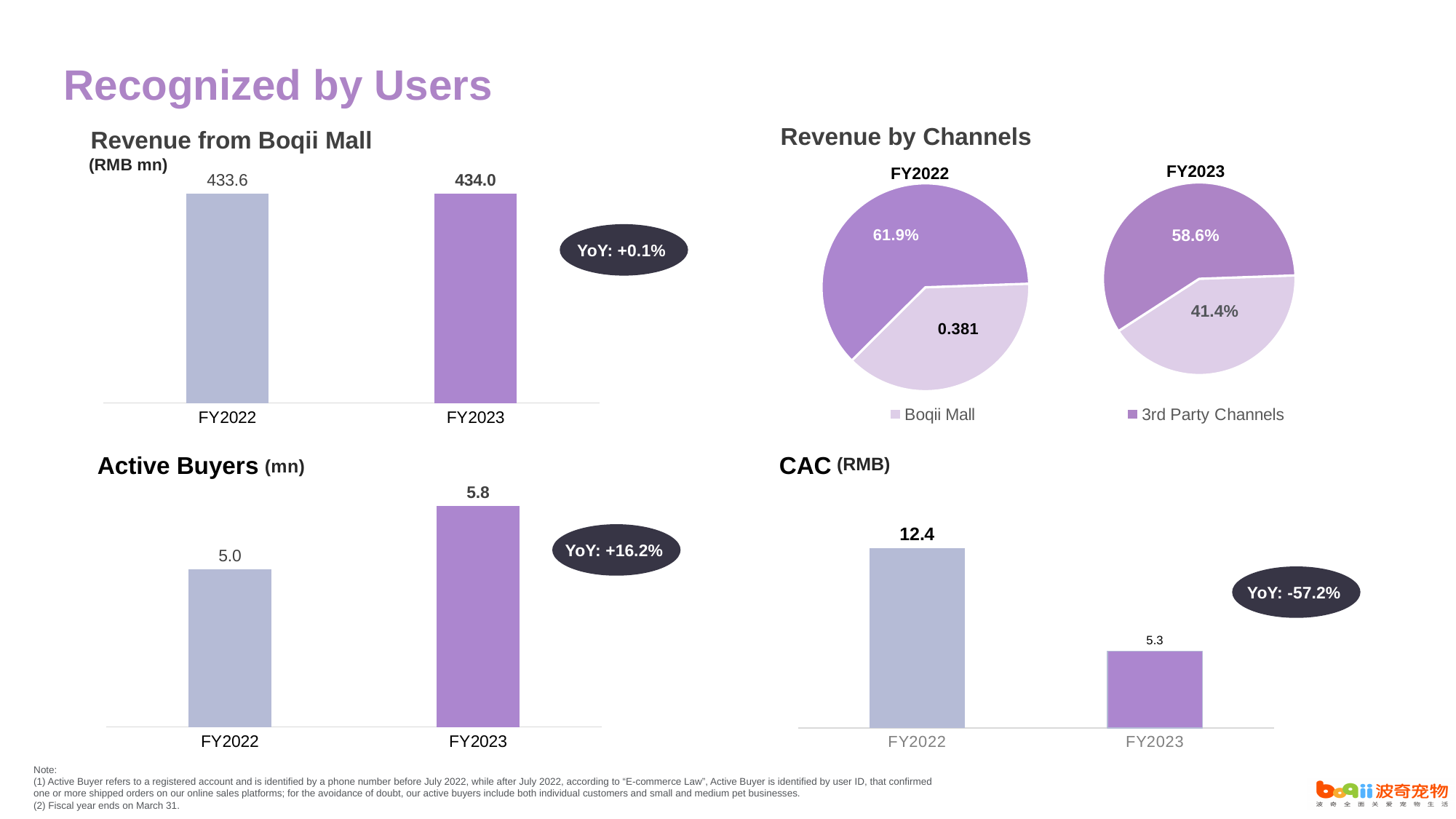
In the CAC chart, what is the value for FY2023? 5.3 In the CAC chart, what is the difference between FY2022 and FY2023? 7.1 In the Revenue from Boqii Mall chart, what is the value for FY2023? 434.0 In the Revenue by Channels FY2023 pie, what share is Boqii Mall? 41.4% In the CAC chart, which fiscal year has the higher value? FY2022 What kind of chart is the Active Buyers chart? bar chart In the Revenue from Boqii Mall chart, what is the value for FY2022? 433.6 In the CAC chart, do values rise or fall from FY2022 to FY2023? fall In the Active Buyers chart, what is the difference between FY2023 and FY2022? 0.8 How many series does the legend of the Revenue by Channels chart list? 2 In the Active Buyers chart, what is the value for FY2023? 5.8 In the Revenue by Channels FY2023 pie, what share is 3rd Party Channels? 58.6%